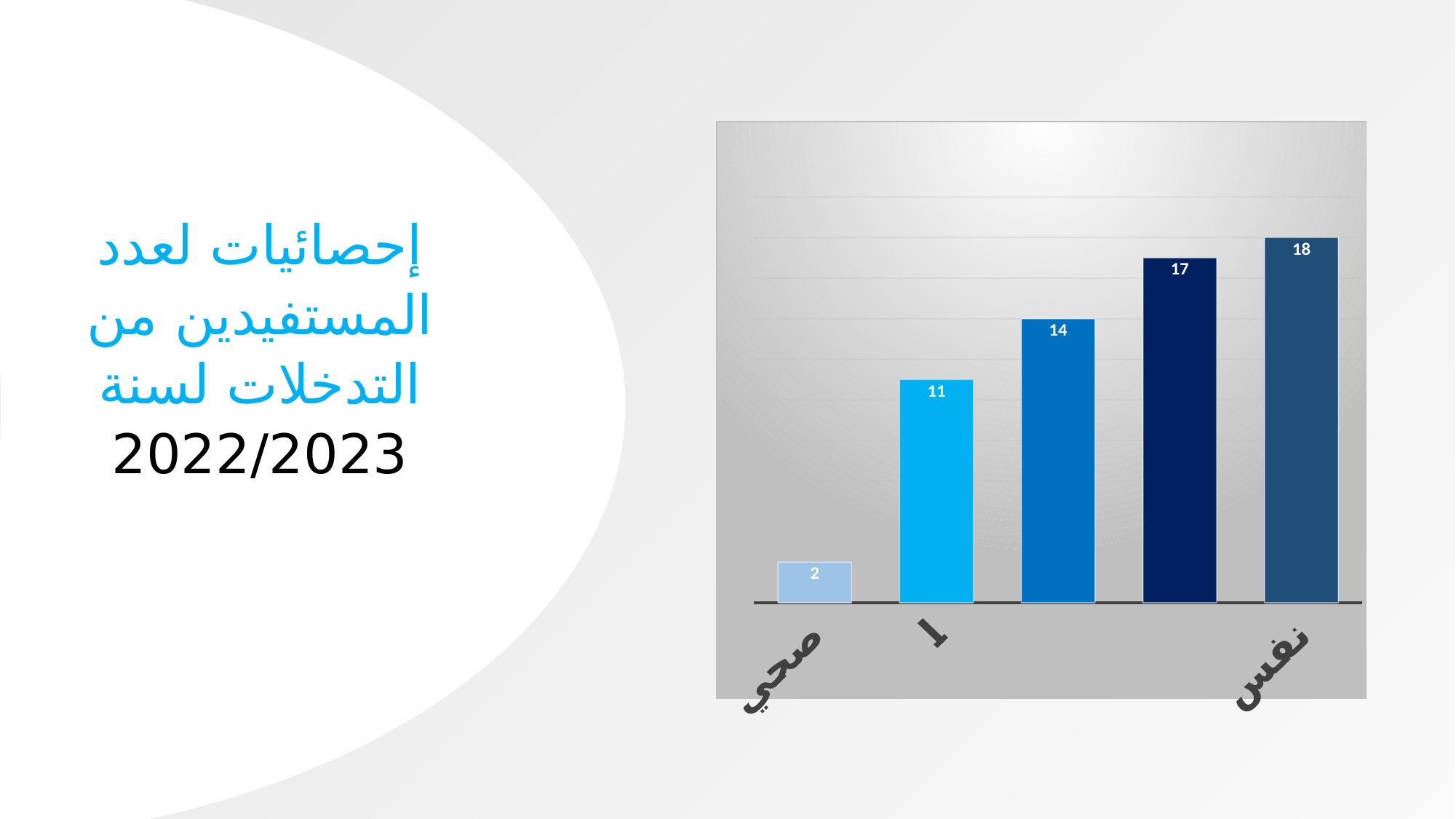
What is the value of the second bar from the left? 11 Which is larger: the value of the second bar from the left or the value of the bar labelled صحي? the second bar from the left What is the value of the middle (third) bar? 14 What year range is mentioned in the slide title next to the chart? 2022/2023 What is the difference between the highest bar (18) and the bar labelled صحي (2)? 16 Do the bar values rise or fall from left to right across the chart? rise What is the highest value shown in the chart? 18 What type of chart is shown on the slide? bar chart How many bars are plotted in the chart? 5 Which category has the lowest value in the chart? صحي What is the value of the bar labelled صحي? 2 What is the value of the fourth bar from the left? 17